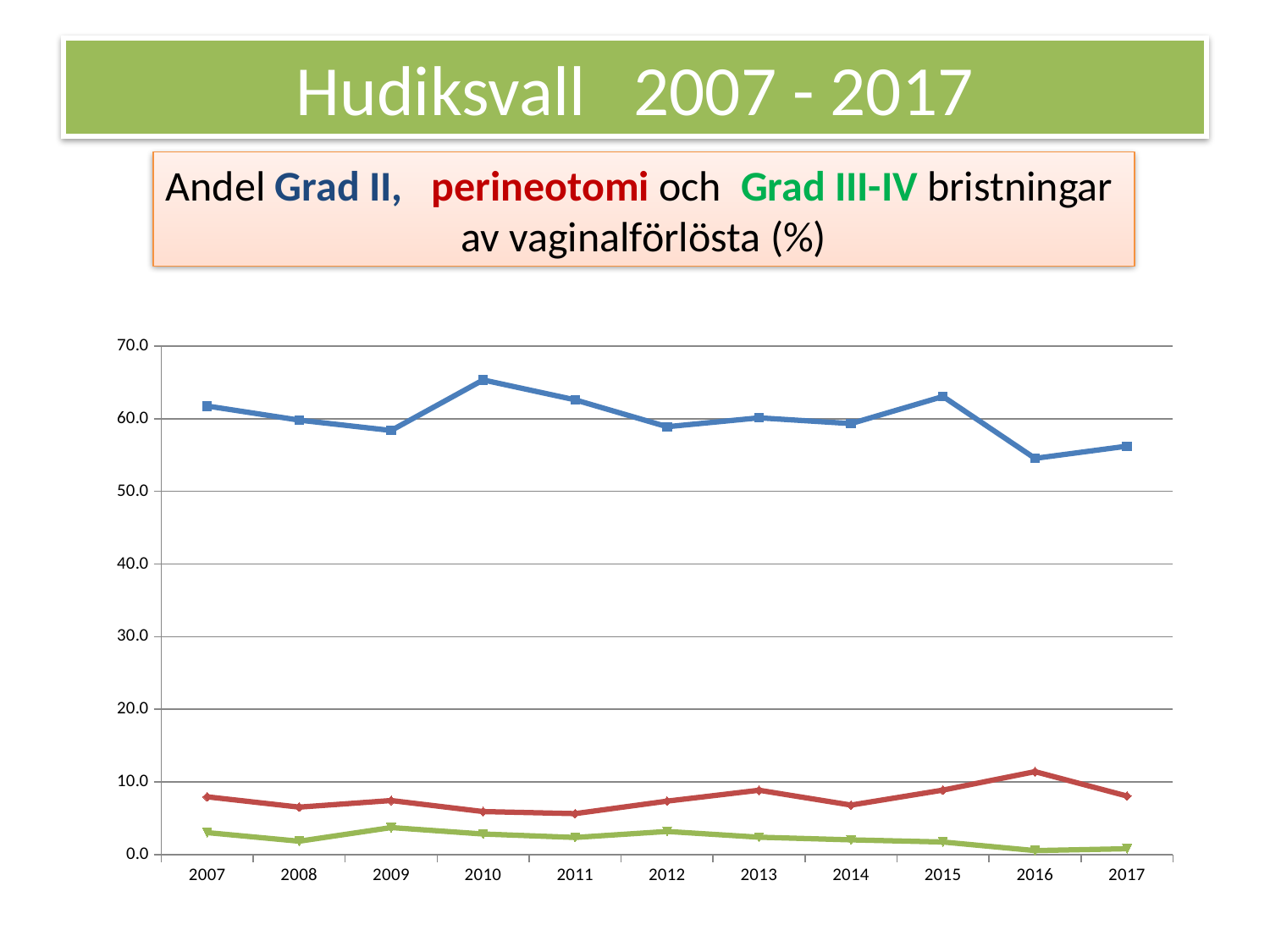
Is the value of the red perineotomi line in 2016 greater or less than 10.0? greater Does the blue Grad II line rise or fall from 2015 to 2016? fall What kind of chart is shown on the slide? line chart Is the value of the blue Grad II line in 2010 greater or less than 60.0? greater Which is larger for the red perineotomi line: the value in 2013 or the value in 2016? 2016 How many years are plotted along the x axis of the chart? 11 Is the value of the blue Grad II line in 2016 greater or less than 60.0? less Which colour is used for the Grad II series on the chart? blue How many lines (series) are plotted on the chart? 3 In which year does the red perineotomi line reach its highest value? 2016 In which year does the blue Grad II line reach its highest value? 2010 In which year does the blue Grad II line reach its lowest value? 2016